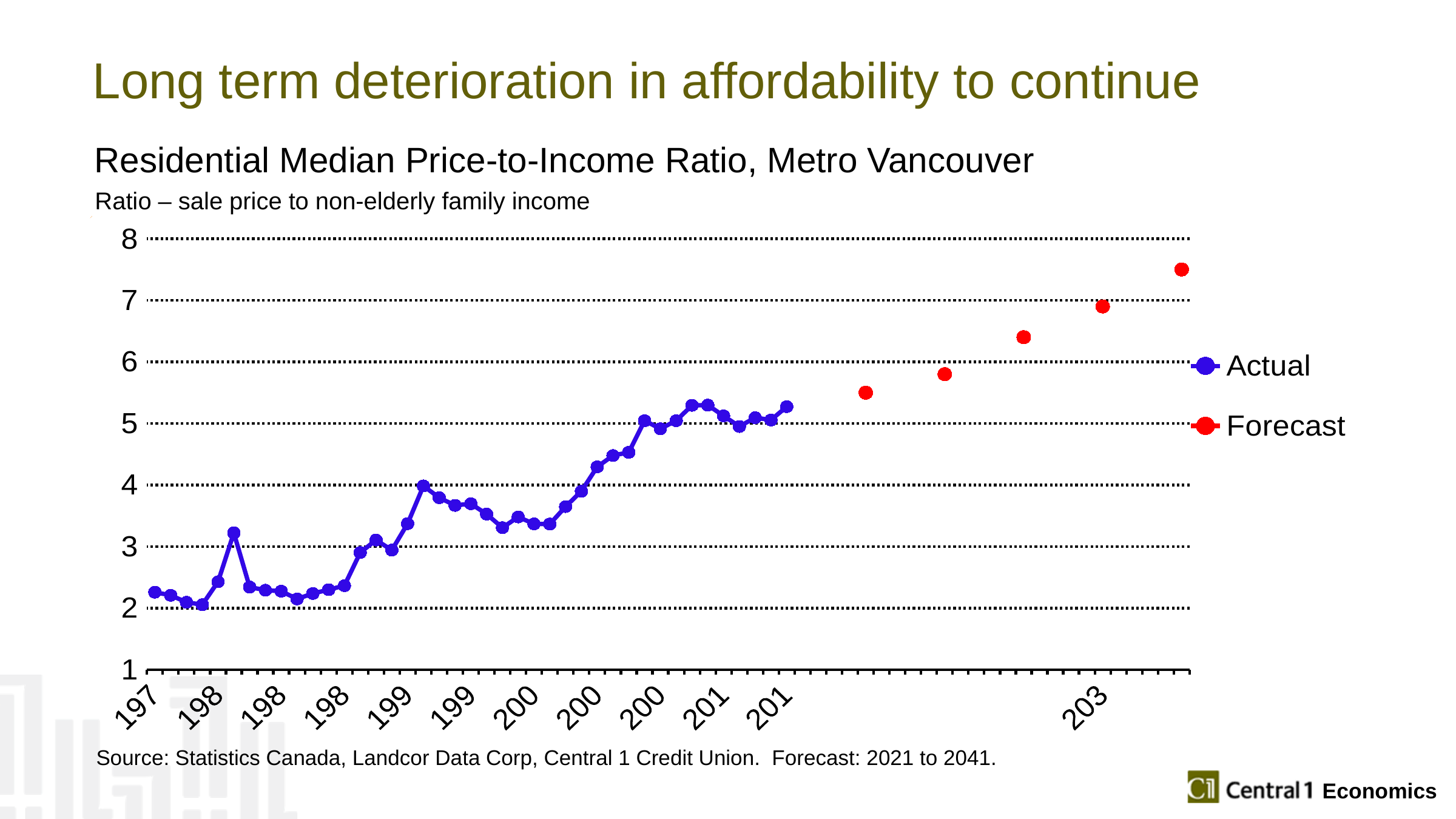
Which series reaches the higher values, Actual or Forecast? Forecast How many series does the legend list? 2 Is the highest Actual value greater or less than 6? less What kind of chart is shown on the slide? line chart Is the lowest Actual value greater or less than 3? less How many Forecast data points are plotted? 5 Is the first Forecast point greater or less than 5? greater What is the title of the chart? Residential Median Price-to-Income Ratio, Metro Vancouver Do the plotted values generally rise or fall from left to right along the x axis? rise What are the two series named in the legend? Actual and Forecast